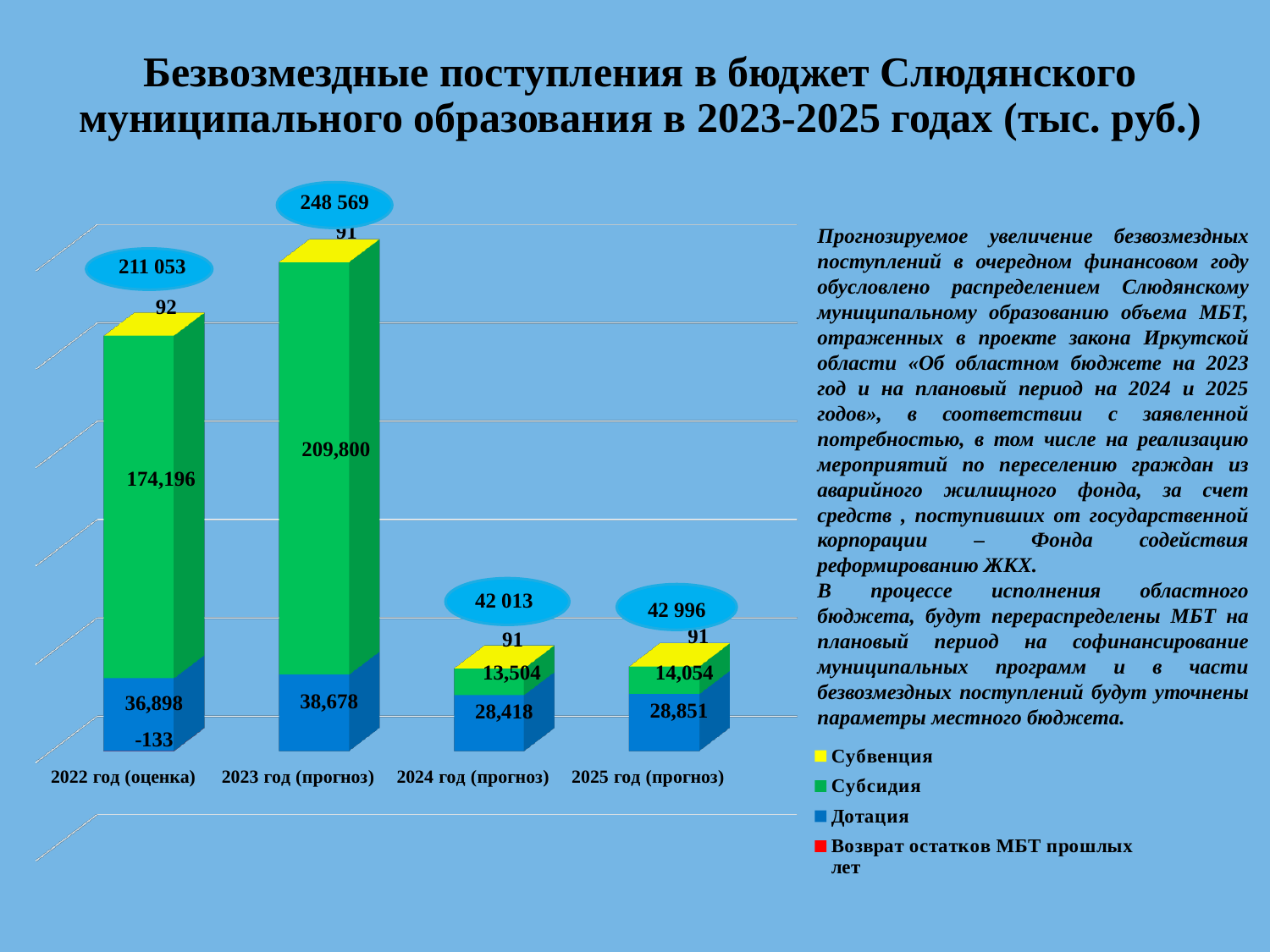
Which year has the lowest Дотация value? 2024 год (прогноз) What is the value of Возврат остатков МБТ прошлых лет for 2022 год (оценка)? -133 What is the value of Дотация for 2022 год (оценка)? 36,898 Which is larger: Дотация for 2023 год (прогноз) or Дотация for 2022 год (оценка)? 2023 год (прогноз) What type of chart is shown on the slide? Stacked bar chart What is the difference between the Субсидия values for 2025 год (прогноз) and 2024 год (прогноз)? 550 What is the total shown above the bar for 2023 год (прогноз)? 248 569 What is the value of Субсидия for 2023 год (прогноз)? 209,800 How many series does the legend list? 4 Which year has the highest Субсидия value? 2023 год (прогноз) How many year categories are shown on the x axis? 4 What is the value of Субвенция for 2025 год (прогноз)? 91